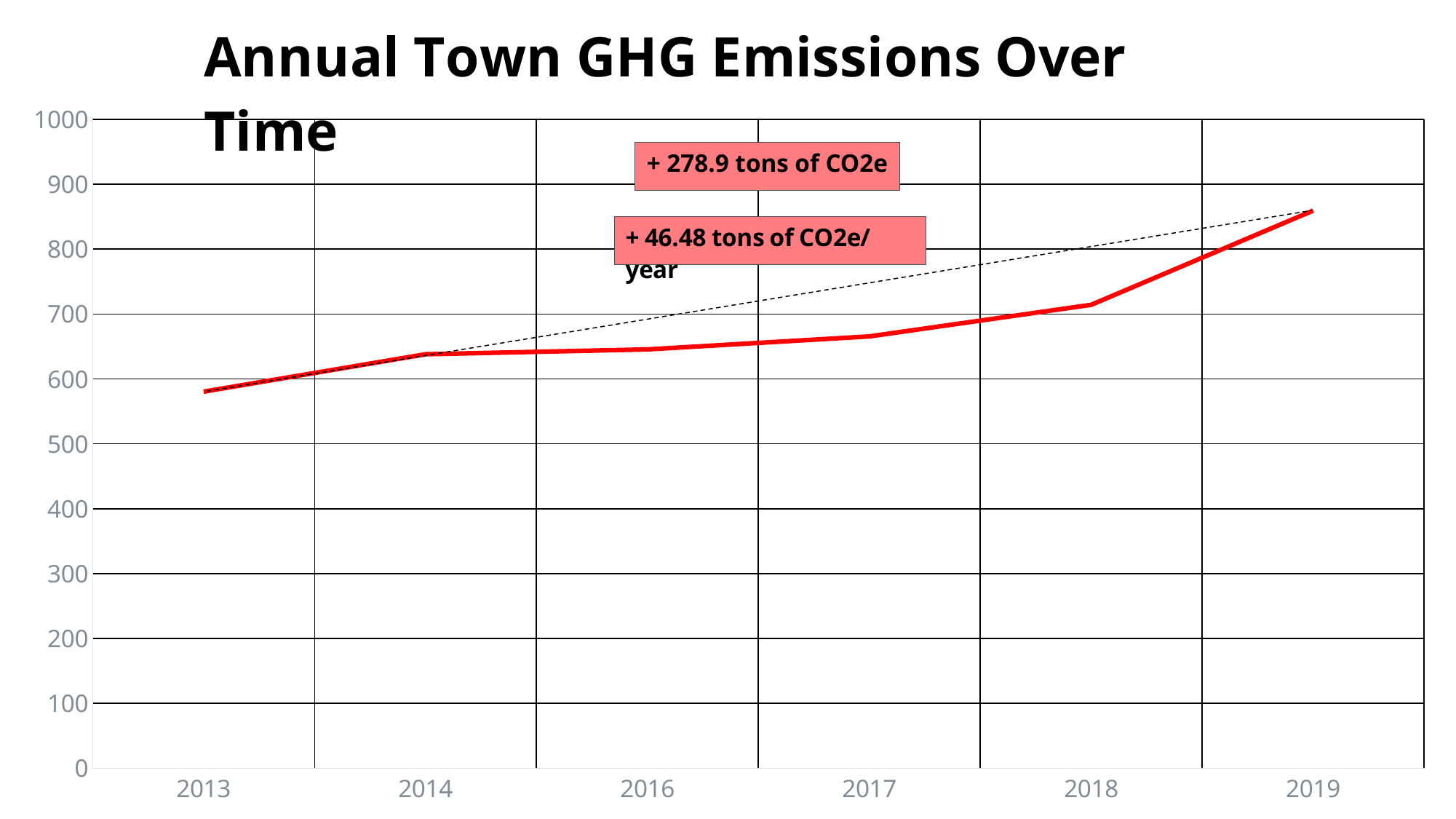
Is the value for 2016 greater or less than 700? less Which year has the highest emissions? 2019 What is the title of the chart? Annual Town GHG Emissions Over Time What kind of chart is shown on the slide? line chart How many years are plotted along the x axis? 6 Is the value for 2013 greater or less than 600? less Which year has higher emissions, 2018 or 2016? 2018 According to the annotation on the chart, what is the total increase in emissions? + 278.9 tons of CO2e Is the value for 2018 greater or less than 700? greater Which year has the lowest emissions? 2013 Do the emissions generally rise or fall from 2013 to 2019? rise